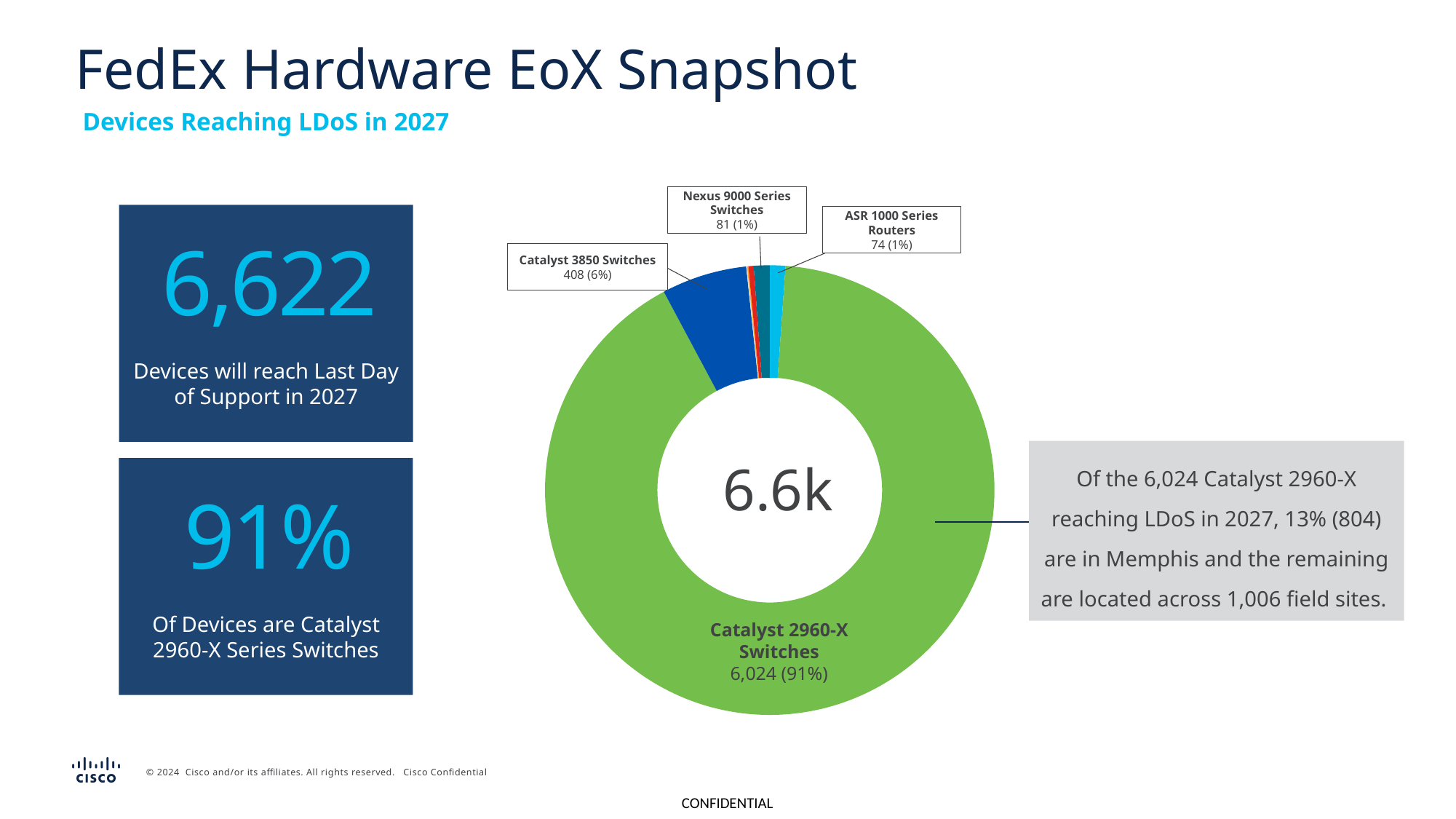
What label is printed in the center of the donut chart? 6.6k What share of the chart do Catalyst 2960-X Switches represent? 91% What is the value shown for ASR 1000 Series Routers? 74 What is the difference between the values for Catalyst 3850 Switches and Nexus 9000 Series Switches? 327 What kind of chart is shown on the slide? donut (pie) chart What is the value shown for Catalyst 3850 Switches? 408 Which is larger, the value for Nexus 9000 Series Switches or ASR 1000 Series Routers? Nexus 9000 Series Switches What is the value shown for Nexus 9000 Series Switches? 81 Which category has the largest slice in the chart? Catalyst 2960-X Switches What share of the chart do Catalyst 3850 Switches represent? 6% How many Catalyst 2960-X Switches are shown in the chart? 6,024 Of the labeled categories, which has the smallest value? ASR 1000 Series Routers